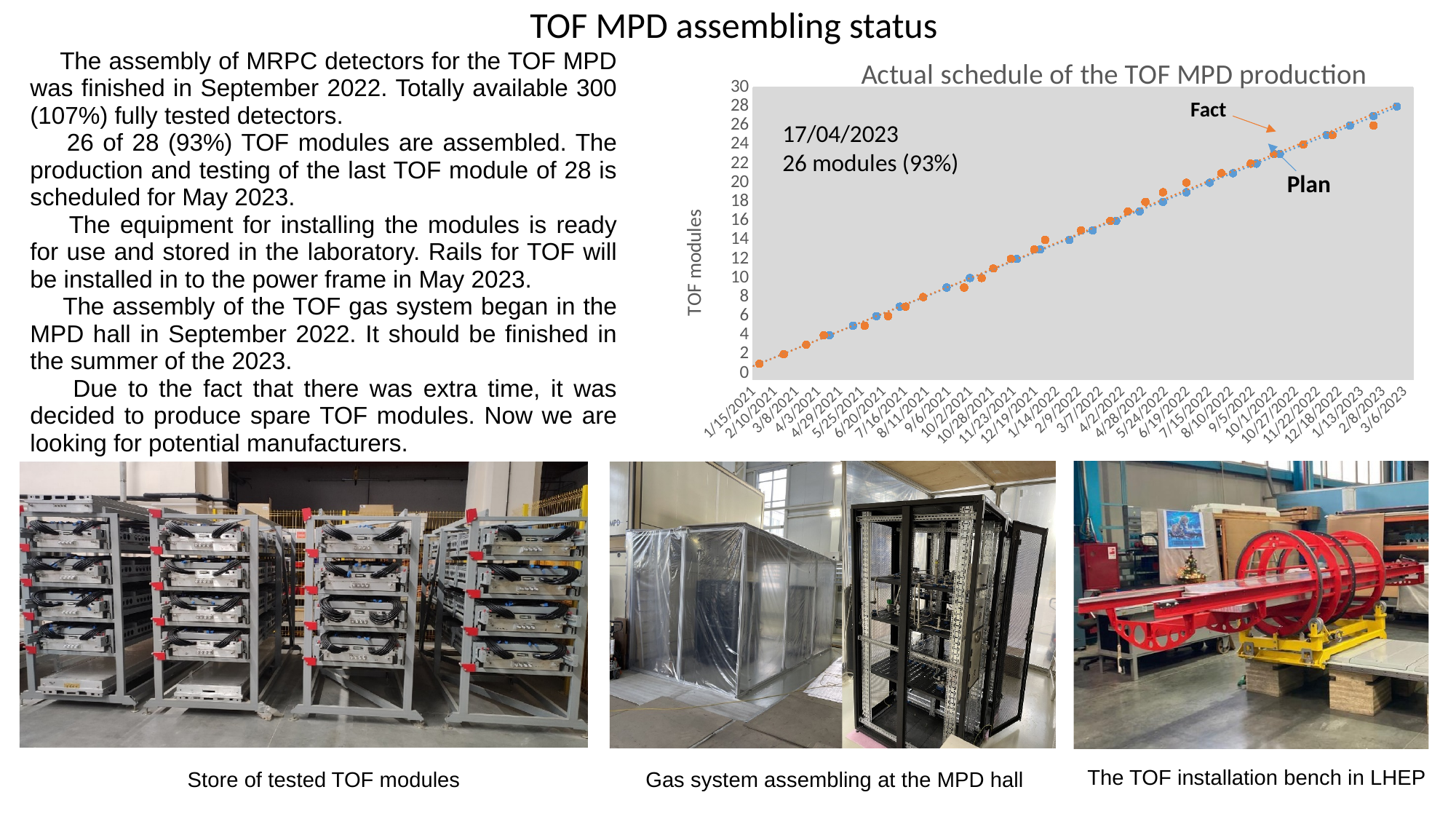
How many series are plotted in the chart? 2 What is the title of the chart? Actual schedule of the TOF MPD production What is the last date label on the x axis of the chart? 3/6/2023 What are the names of the two series in the chart? Fact and Plan According to the annotation on the chart, how many modules were completed as of 17/04/2023? 26 modules (93%) What is the label of the y axis of the chart? TOF modules Do the values in the chart rise or fall along the x axis over time? Rise What is the first date label on the x axis of the chart? 1/15/2021 What is the highest tick value shown on the y axis of the chart? 30 What kind of chart is shown on the slide? Scatter chart